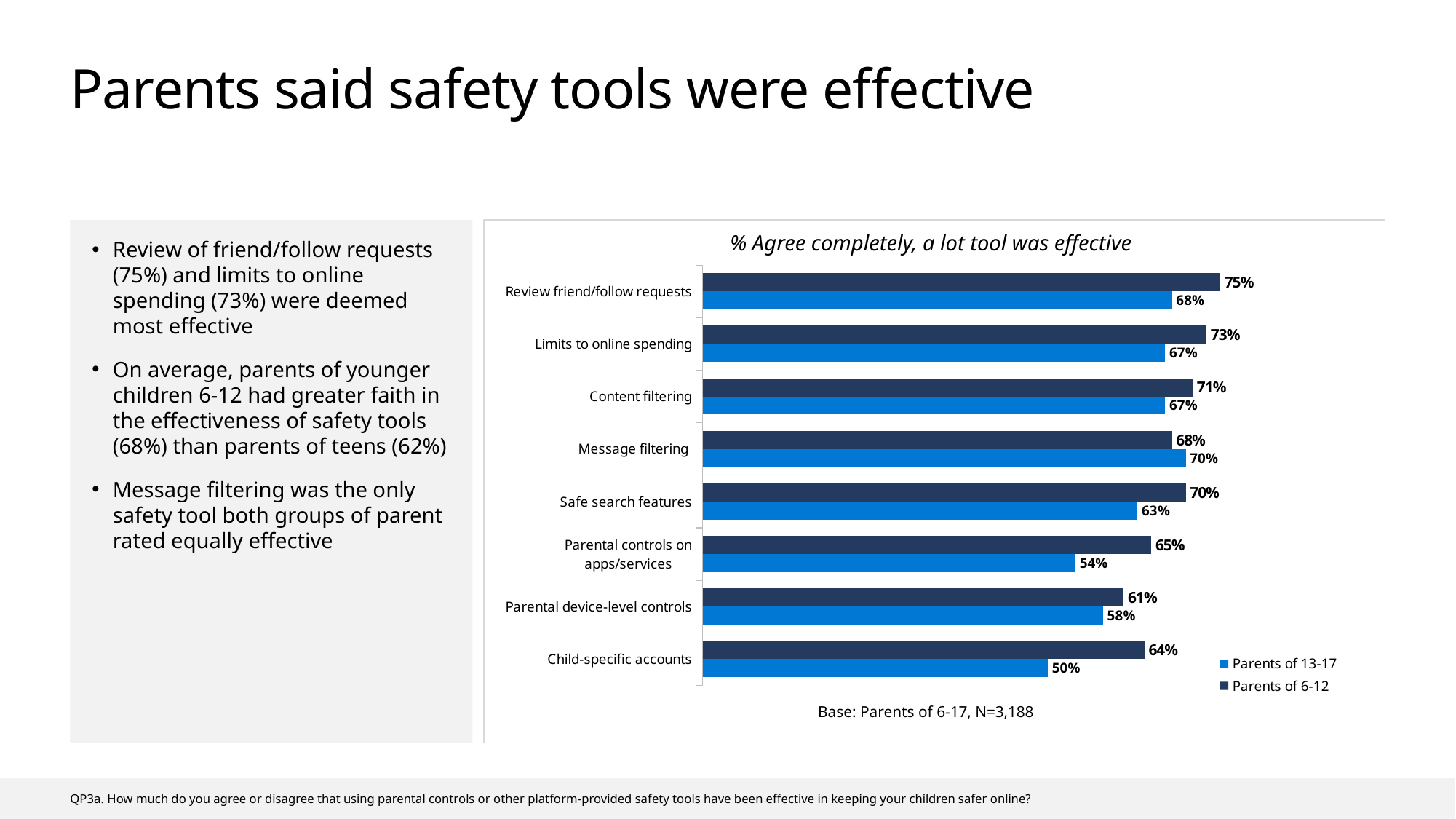
How many series does the legend list? 2 Which safety tool has the highest value for parents of 6-12? Review friend/follow requests What is the title of the chart? % Agree completely, a lot tool was effective What is the difference between parents of 6-12 and parents of 13-17 for Child-specific accounts? 14 percentage points What percentage of parents of 6-12 agreed that reviewing friend/follow requests was effective? 75% For Message filtering, which group has the higher value: parents of 13-17 or parents of 6-12? Parents of 13-17 What kind of chart is shown on the slide? Bar chart Which safety tool has the lowest value for parents of 13-17? Child-specific accounts What is the value for Message filtering among parents of 13-17? 70% What percentage of parents of 13-17 agreed that child-specific accounts were effective? 50% What is the base sample size shown below the chart? N=3,188 How many safety tools are listed on the chart? 8